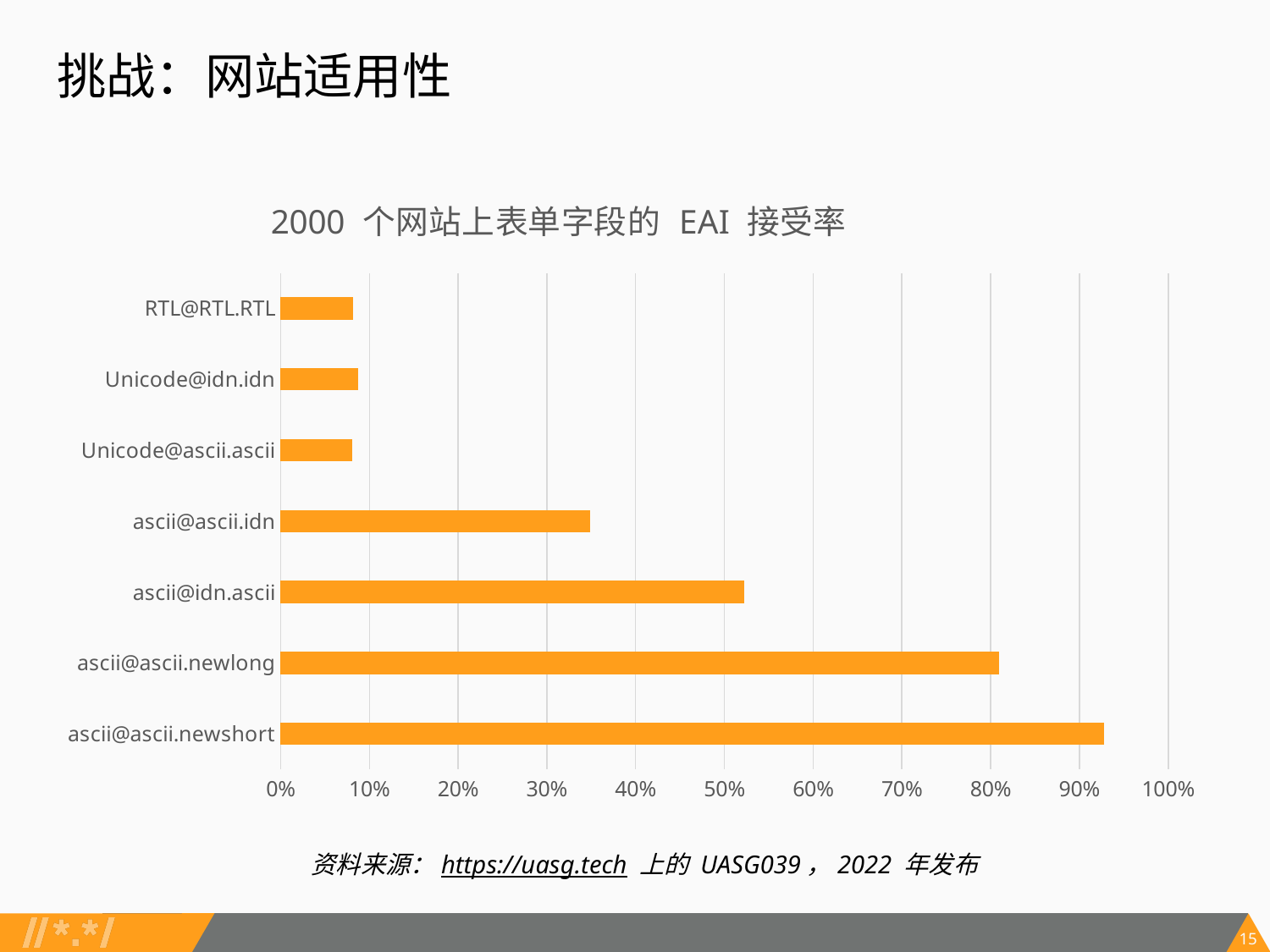
Which is larger, the value for ascii@ascii.idn or the value for Unicode@idn.idn? ascii@ascii.idn How many categories are plotted in the chart? 7 What kind of chart is shown on the slide? bar chart Is the value for RTL@RTL.RTL greater or less than 10%? less Is the value for ascii@ascii.newshort greater or less than 90%? greater Is the value for ascii@ascii.idn greater or less than 40%? less Which category has the highest EAI acceptance rate? ascii@ascii.newshort Which is larger, the value for ascii@ascii.newlong or the value for ascii@idn.ascii? ascii@ascii.newlong What is the title of the chart? 2000 个网站上表单字段的 EAI 接受率